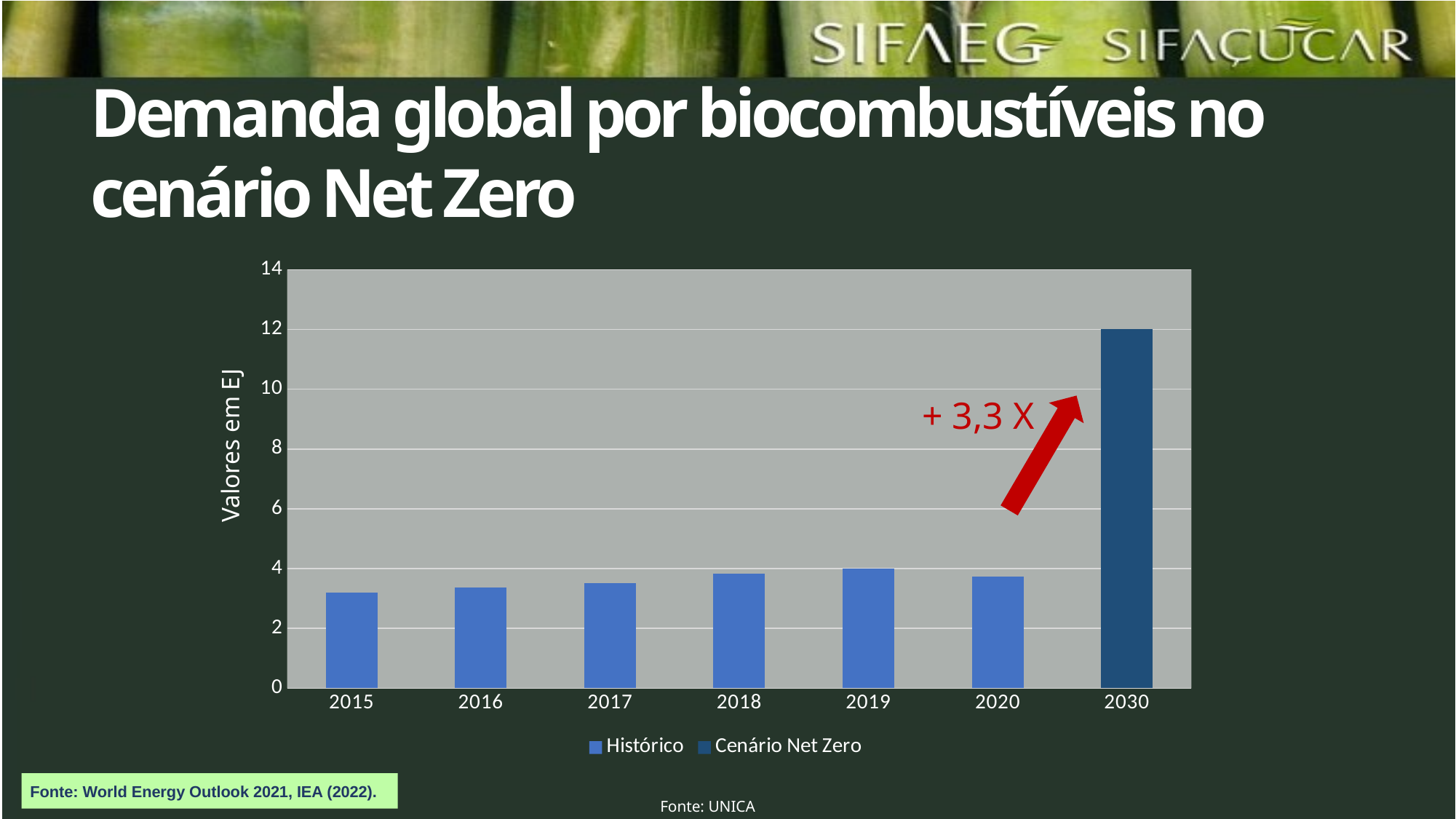
What is the label on the y axis of the chart? Valores em EJ Is the value for 2020 greater or less than 2? greater Which year has the lowest bar in the chart? 2015 Which year has the highest bar in the chart? 2030 Which is larger, the value for 2019 or the value for 2015? 2019 What are the two series named in the chart legend? Histórico and Cenário Net Zero Do the values rise or fall from 2015 to 2019? rise How many series does the chart legend list? 2 What kind of chart is shown on the slide? bar chart How many years are shown on the x axis of the chart? 7 Is the value for 2030 greater or less than 10? greater Is the value for 2015 greater or less than 4? less